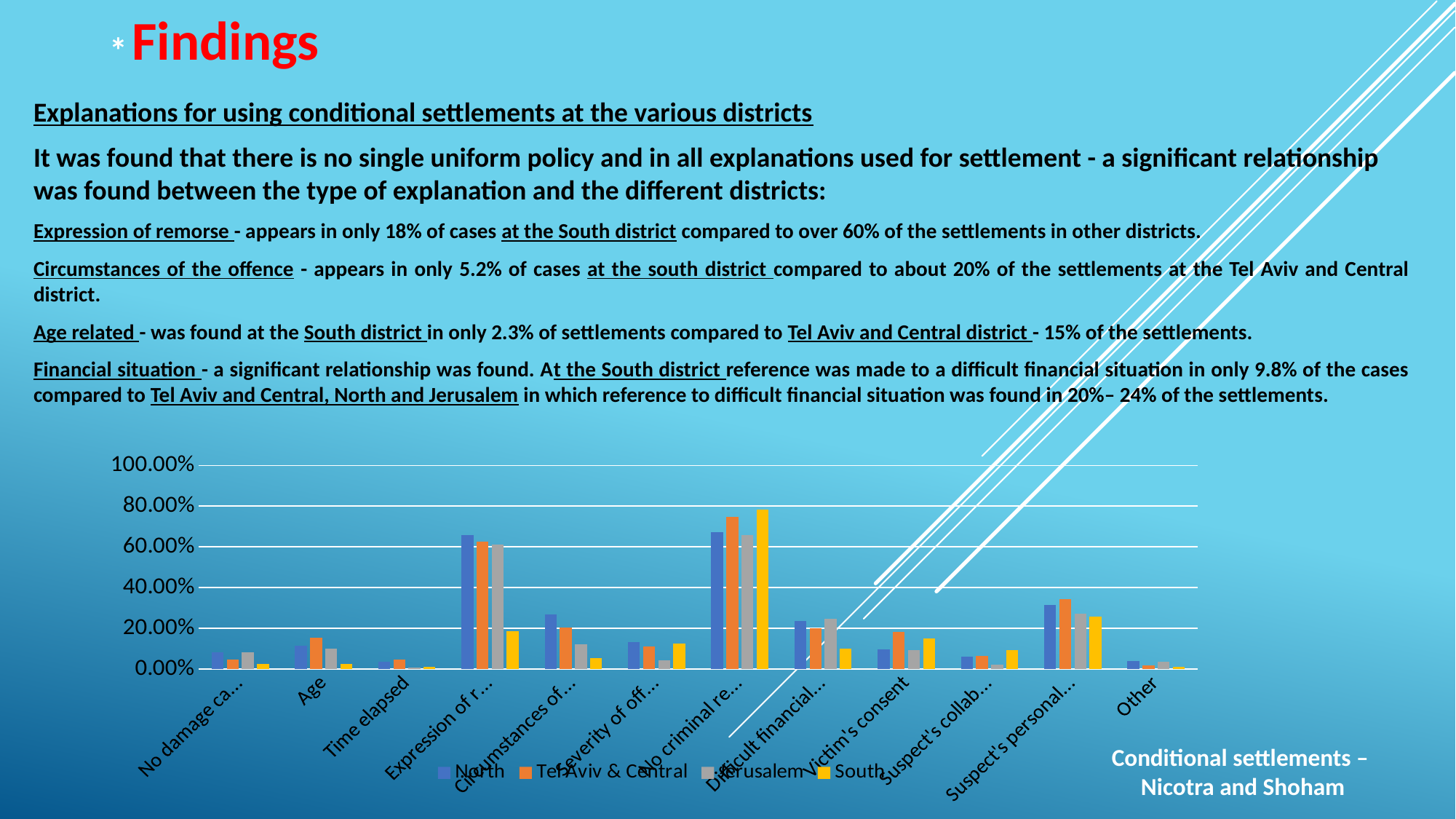
Is the value for Tel Aviv & Central in the Other category greater or less than 20%? less Is the value for South in the Age category greater or less than 20%? less How many series does the chart's legend list? 4 Which colour represents the South district in the chart? yellow What kind of chart is shown on the slide? bar chart Which districts are listed in the chart's legend? North, Tel Aviv & Central, Jerusalem, South In the Age category, which is larger: the value for North or the value for South? North In the Age category, which district has the lowest bar? South Is the value for North in the Victim's consent category greater or less than 20%? less How many categories are shown along the x axis of the chart? 12 In the Age category, which district has the highest bar? Tel Aviv & Central